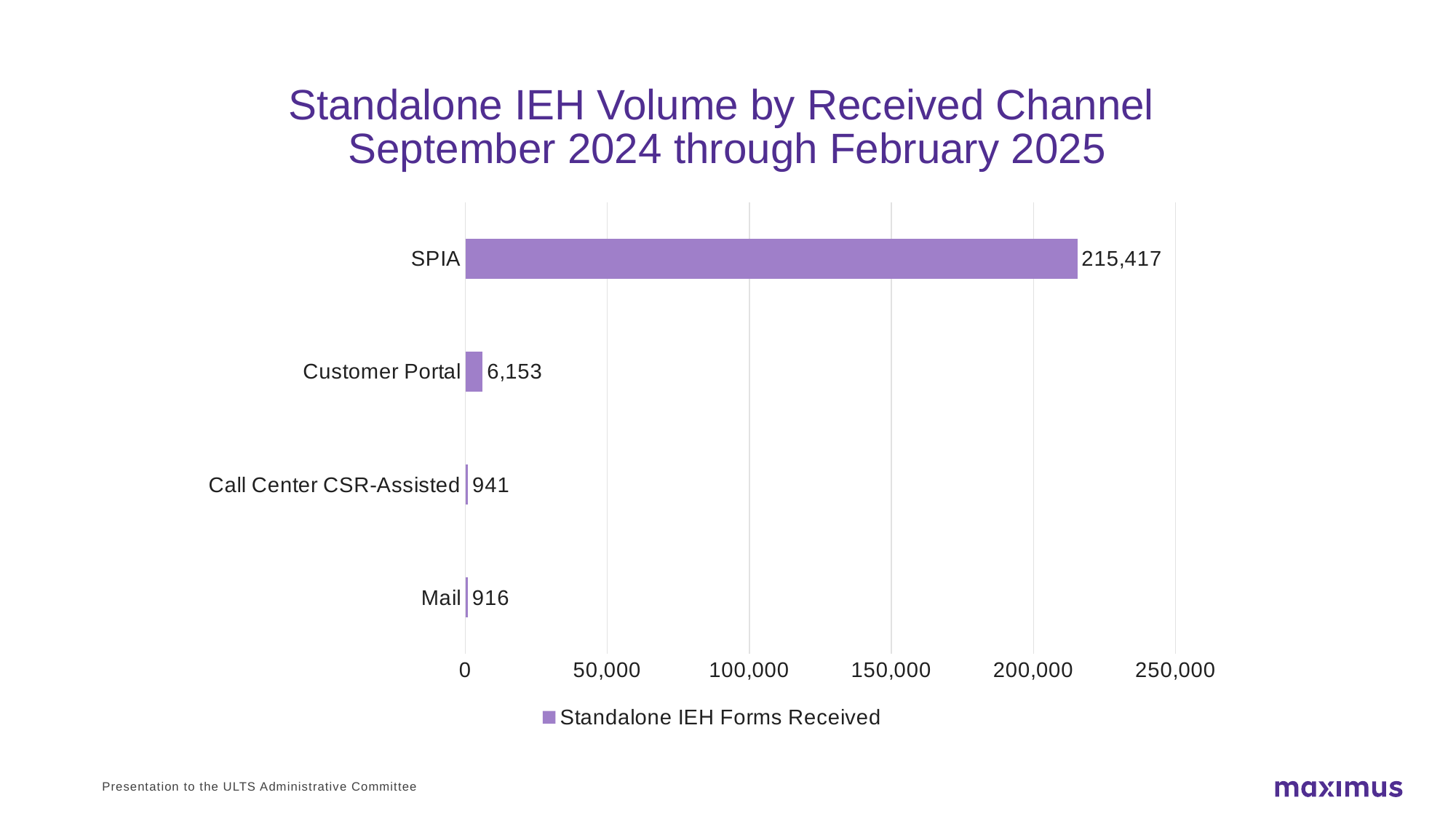
What is the value for SPIA? 215,417 What is the value for Call Center CSR-Assisted? 941 What is the value for Mail? 916 Which channel has the highest volume? SPIA Which channel has the lowest volume? Mail What is the difference between the Call Center CSR-Assisted value and the Mail value? 25 What is the difference between the SPIA value and the Customer Portal value? 209,264 Is the value for SPIA greater or less than 200,000? greater How many channels are shown in the chart? 4 Which is larger, the value for Customer Portal or the value for Call Center CSR-Assisted? Customer Portal What kind of chart is shown on the slide? Bar chart How many Standalone IEH forms were received through the Customer Portal? 6,153